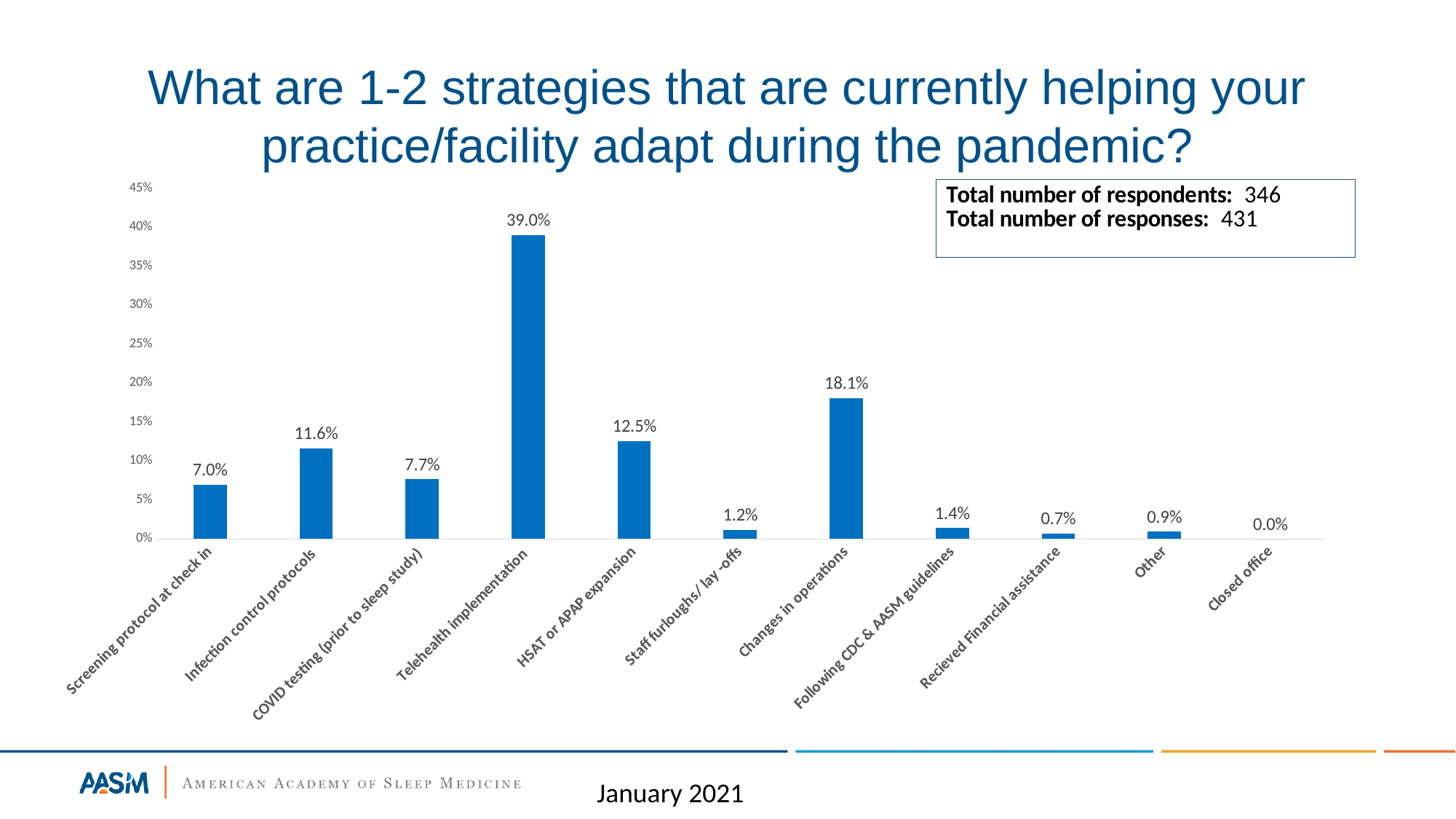
How many categories are shown on the x axis? 11 What kind of chart is shown on the slide? bar chart Which category has the highest value? Telehealth implementation What is the value for Recieved Financial assistance? 0.7% Which is larger, the value for HSAT or APAP expansion or the value for Infection control protocols? HSAT or APAP expansion What is the difference between the values for Telehealth implementation and Changes in operations? 20.9% Which category has the lowest value? Closed office What is the value for Infection control protocols? 11.6% What is the value for Telehealth implementation? 39.0% What is the value for Changes in operations? 18.1% Is the value for COVID testing (prior to sleep study) greater or less than 10%? less What is the total number of respondents stated on the slide? 346